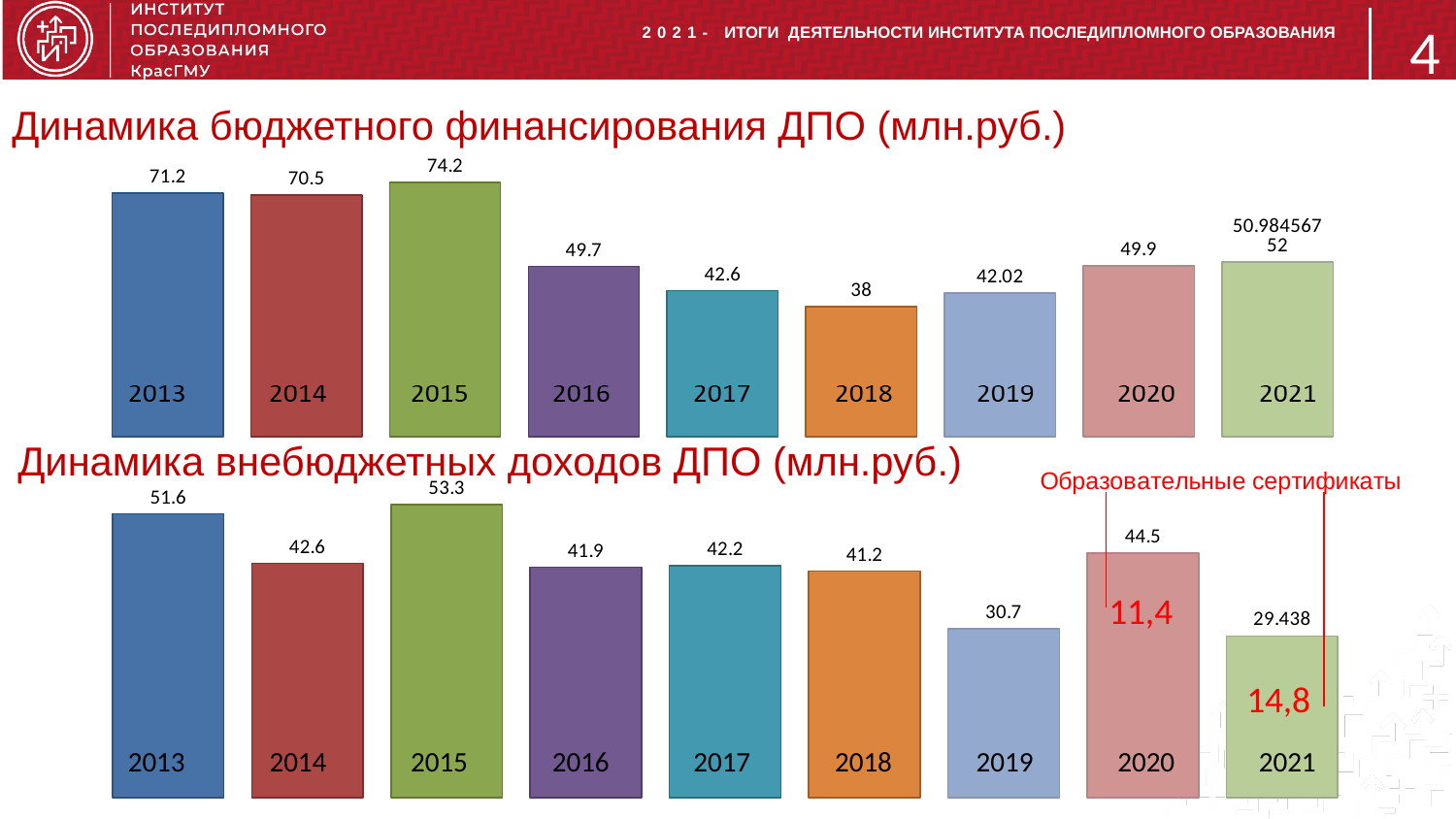
In the chart 'Динамика внебюджетных доходов ДПО (млн.руб.)', which is larger, the value for 2019 or the value for 2018? 2018 In the chart 'Динамика бюджетного финансирования ДПО (млн.руб.)', what is the value for 2019? 42.02 In the chart 'Динамика внебюджетных доходов ДПО (млн.руб.)', which year has the lowest value? 2021 In the chart 'Динамика бюджетного финансирования ДПО (млн.руб.)', which year has the lowest value? 2018 How many years are shown in the chart 'Динамика бюджетного финансирования ДПО (млн.руб.)'? 9 In the chart 'Динамика внебюджетных доходов ДПО (млн.руб.)', which year has the highest value? 2015 What type of chart is 'Динамика внебюджетных доходов ДПО (млн.руб.)'? Bar chart In the chart 'Динамика бюджетного финансирования ДПО (млн.руб.)', which year has the highest value? 2015 In the chart 'Динамика бюджетного финансирования ДПО (млн.руб.)', what is the difference between the values for 2013 and 2016? 21.5 In the chart 'Динамика внебюджетных доходов ДПО (млн.руб.)', what is the value for 2020? 44.5 In the chart 'Динамика внебюджетных доходов ДПО (млн.руб.)', what is the difference between the values for 2015 and 2013? 1.7 In the chart 'Динамика бюджетного финансирования ДПО (млн.руб.)', what is the value for 2015? 74.2